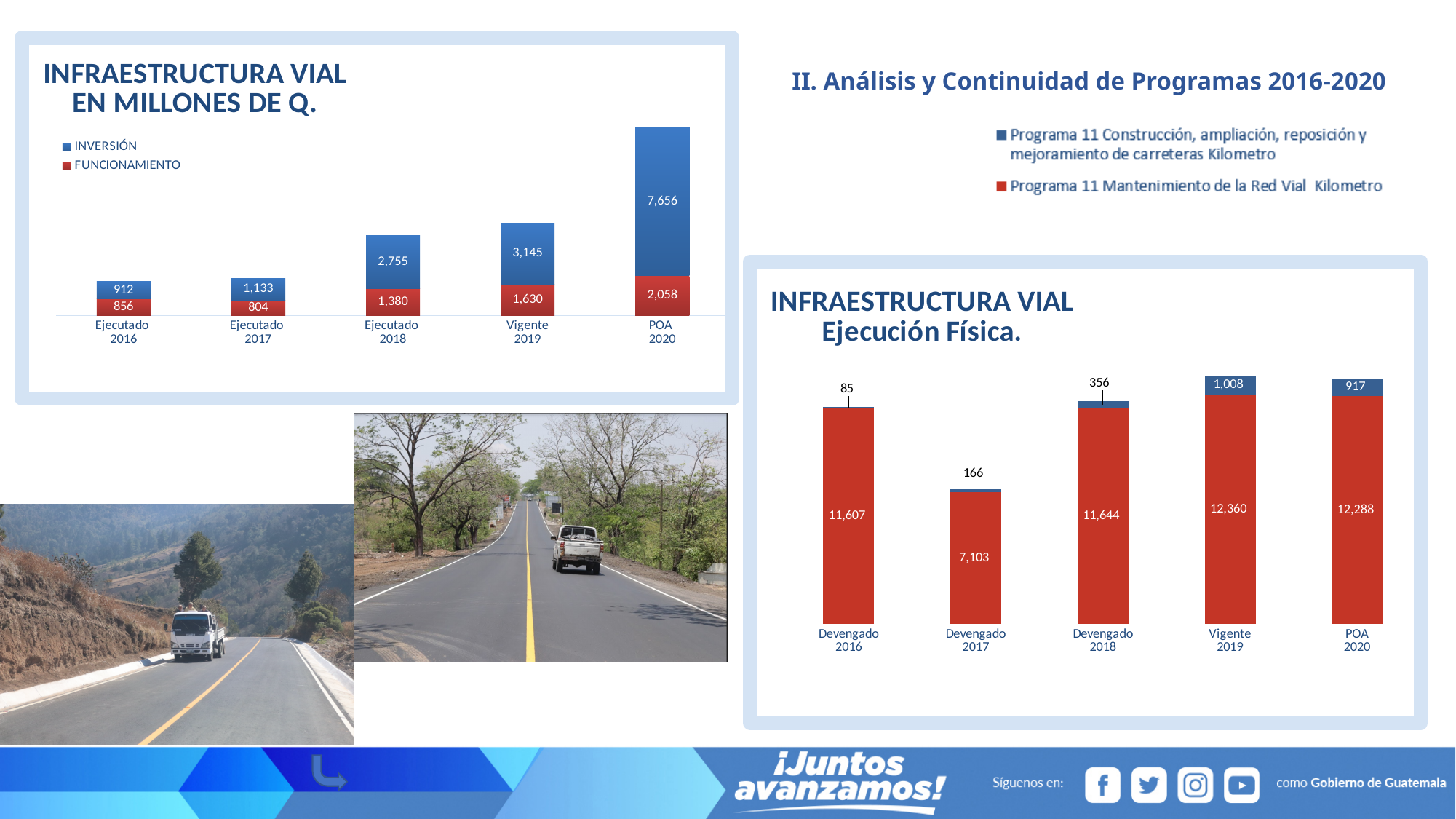
In the chart titled 'INFRAESTRUCTURA VIAL EN MILLONES DE Q.', which category has the lowest FUNCIONAMIENTO value? Ejecutado 2017 In the chart titled 'INFRAESTRUCTURA VIAL EN MILLONES DE Q.', what is the total of the stacked bar for POA 2020? 9,714 In the chart titled 'INFRAESTRUCTURA VIAL EN MILLONES DE Q.', how many series does the legend list? 2 In the chart titled 'INFRAESTRUCTURA VIAL EN MILLONES DE Q.', what is the INVERSIÓN value for POA 2020? 7,656 In the chart titled 'INFRAESTRUCTURA VIAL EN MILLONES DE Q.', what is the difference between the INVERSIÓN values for POA 2020 and Vigente 2019? 4,511 In the chart titled 'INFRAESTRUCTURA VIAL Ejecución Física.', which category has the highest value for Programa 11 Construcción, ampliación, reposición y mejoramiento de carreteras Kilometro? Vigente 2019 In the chart titled 'INFRAESTRUCTURA VIAL Ejecución Física.', what is the value for Programa 11 Mantenimiento de la Red Vial Kilometro for Devengado 2017? 7,103 In the chart titled 'INFRAESTRUCTURA VIAL Ejecución Física.', how many categories are shown on the x axis? 5 In the chart titled 'INFRAESTRUCTURA VIAL EN MILLONES DE Q.', what is the FUNCIONAMIENTO value for Ejecutado 2018? 1,380 What kind of chart is the one titled 'INFRAESTRUCTURA VIAL Ejecución Física.'? stacked bar chart In the chart titled 'INFRAESTRUCTURA VIAL Ejecución Física.', what is the total of the stacked bar for Vigente 2019? 13,368 In the chart titled 'INFRAESTRUCTURA VIAL EN MILLONES DE Q.', does the INVERSIÓN value rise or fall from Ejecutado 2016 to POA 2020? rise